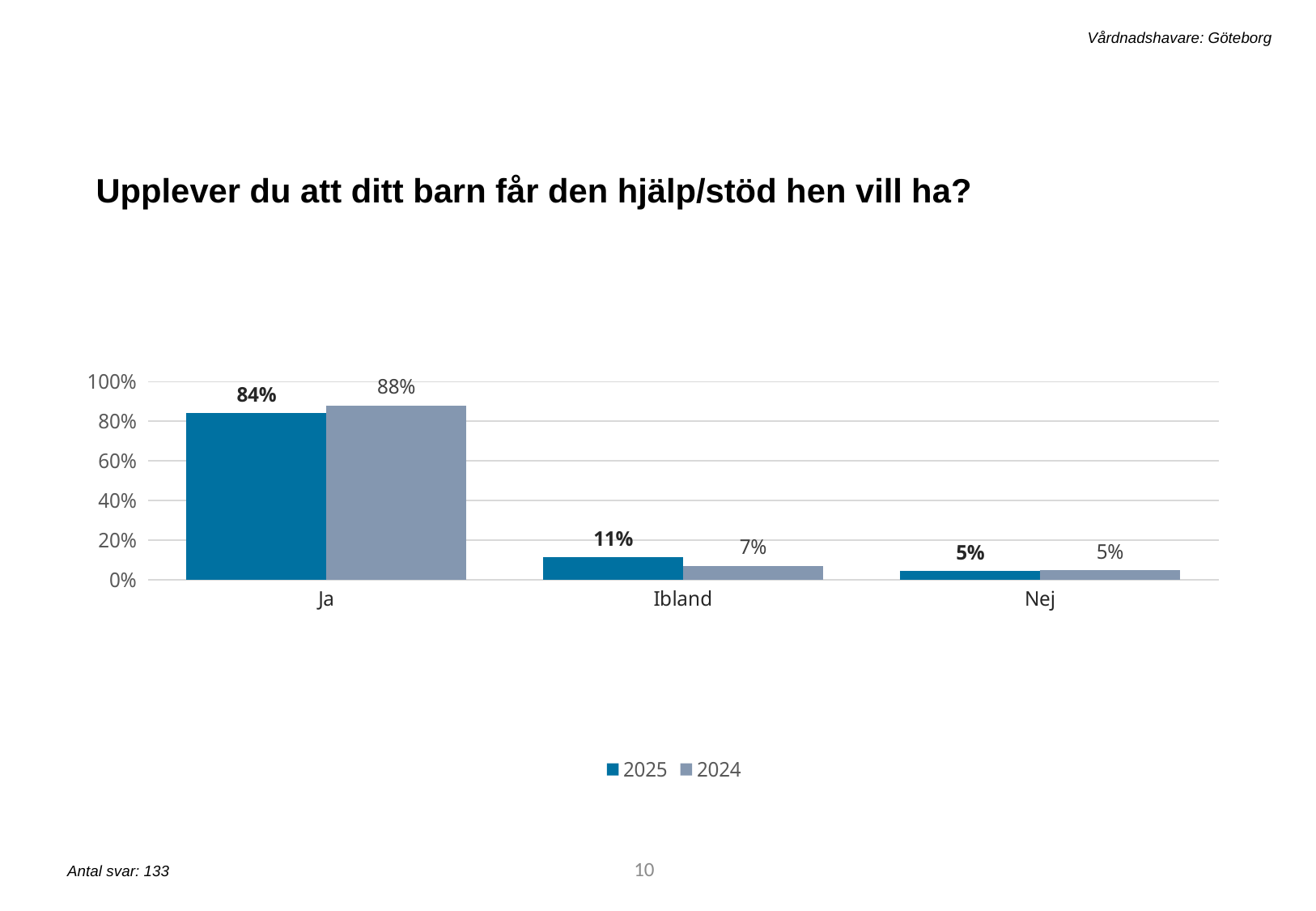
How many series does the legend list? 2 What is the value for "Ja" in the 2025 series? 84% What kind of chart is shown on the slide? Bar chart What is the value for "Nej" in the 2024 series? 5% What is the difference between the 2024 and 2025 values for "Ja"? 4% What is the title of the chart? Upplever du att ditt barn får den hjälp/stöd hen vill ha? What is the value for "Ja" in the 2024 series? 88% Which is larger for "Ibland": the 2025 value or the 2024 value? 2025 How many categories are shown on the x axis? 3 Which category has the lowest value in the 2024 series? Nej What is the value for "Ibland" in the 2025 series? 11% Which category has the highest value in the 2025 series? Ja